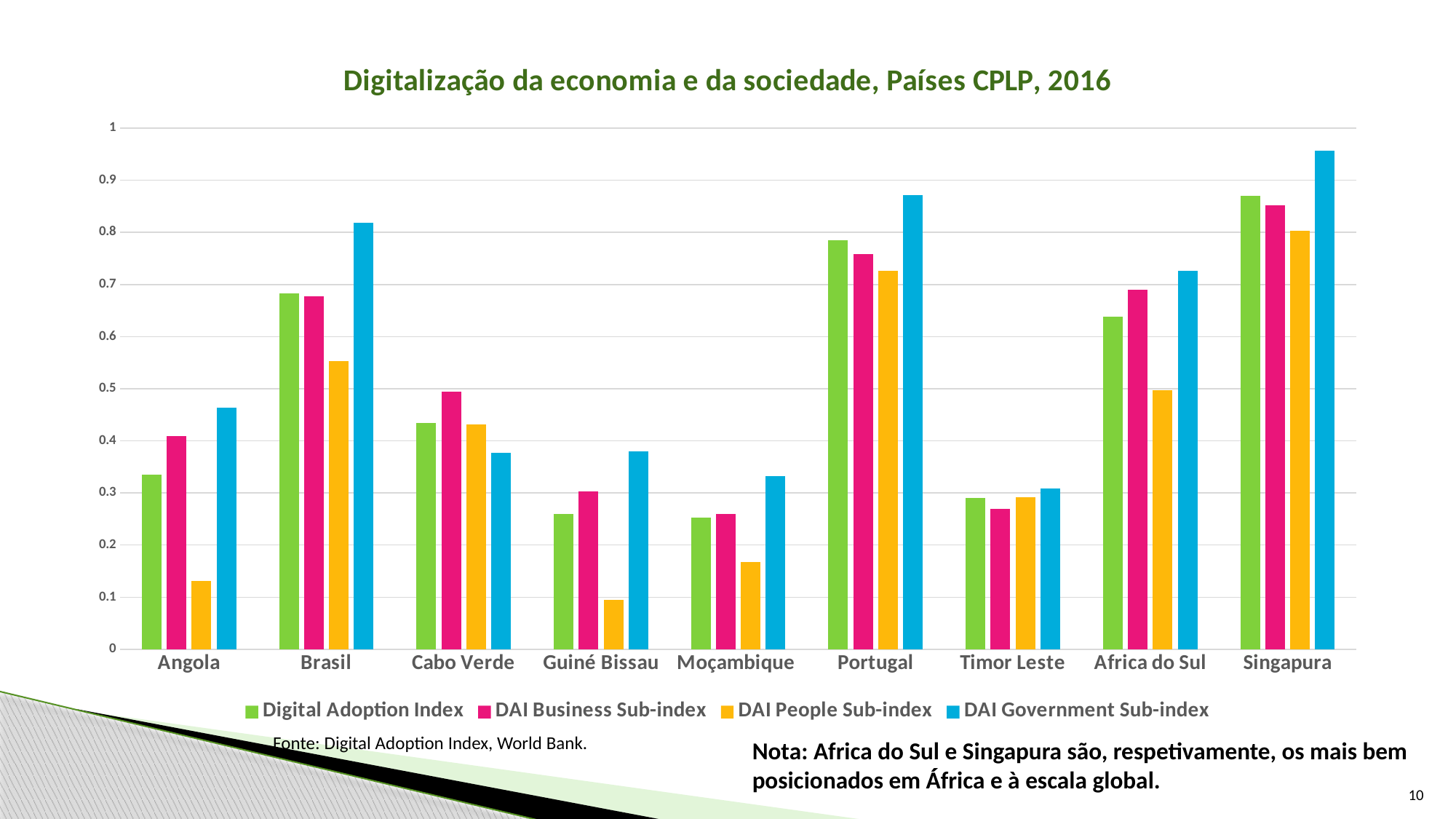
Which country has the highest DAI Government Sub-index value? Singapura Which country has the lowest DAI People Sub-index value? Guiné Bissau How many countries are shown on the x axis of the chart? 9 Is the DAI People Sub-index value for Angola greater or less than 0.2? less Is the DAI Government Sub-index value for Brasil greater or less than 0.8? greater How many series does the legend list? 4 What kind of chart is shown on the slide? Bar chart For Cabo Verde, which is larger, the DAI Business Sub-index or the DAI Government Sub-index? DAI Business Sub-index Is the DAI Government Sub-index value for Moçambique greater or less than 0.4? less Which country has the highest Digital Adoption Index value? Singapura What is the title of the chart? Digitalização da economia e da sociedade, Países CPLP, 2016 Which has the larger Digital Adoption Index value, Portugal or Brasil? Portugal